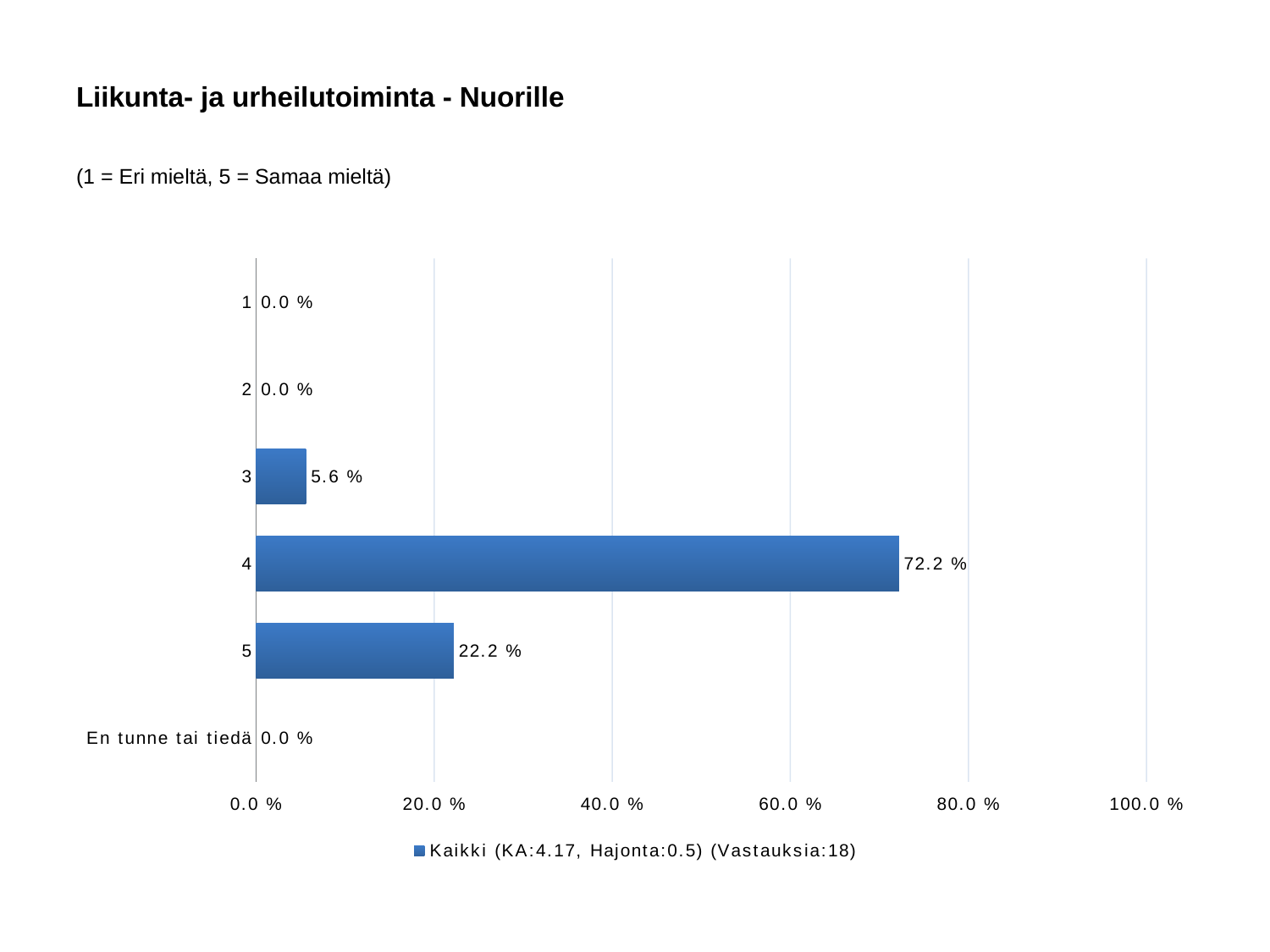
What is the value for 'En tunne tai tiedä'? 0.0 % What is the value for category 4? 72.2 % Is the value for category 4 greater or less than 60.0 %? greater What kind of chart is shown on the slide? bar chart How many categories are shown on the chart? 6 Which is larger, the value for category 3 or category 5? 5 Which category has the highest value? 4 What is the value for category 5? 22.2 % What is the difference between the values for category 4 and category 5? 50.0 % What is the title of the chart? Liikunta- ja urheilutoiminta - Nuorille How many series does the legend list? 1 What is the value for category 3? 5.6 %